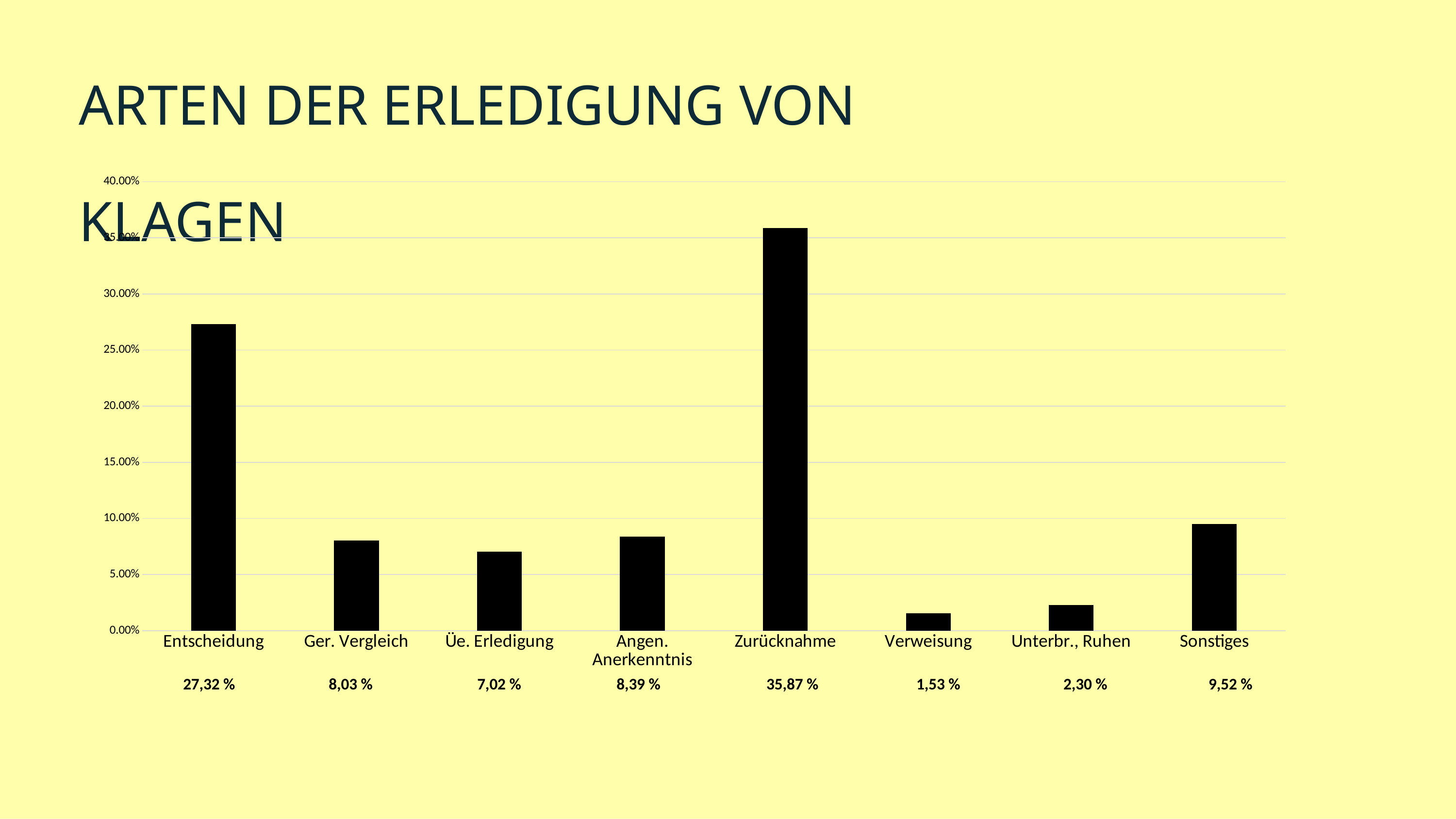
What is the value for Entscheidung? 27,32 % What is the value for Verweisung? 1,53 % What is the value for Zurücknahme? 35,87 % Which category has the lowest value? Verweisung What is the difference between the values for Zurücknahme and Entscheidung? 8,55 % Which is larger, the value for Ger. Vergleich or the value for Üe. Erledigung? Ger. Vergleich What is the difference between the values for Sonstiges and Angen. Anerkenntnis? 1,13 % How many categories are shown on the x axis? 8 What is the value for Sonstiges? 9,52 % What kind of chart is shown on the slide? bar chart Which category has the highest value? Zurücknahme Is the value for Entscheidung greater or less than 25.00%? greater